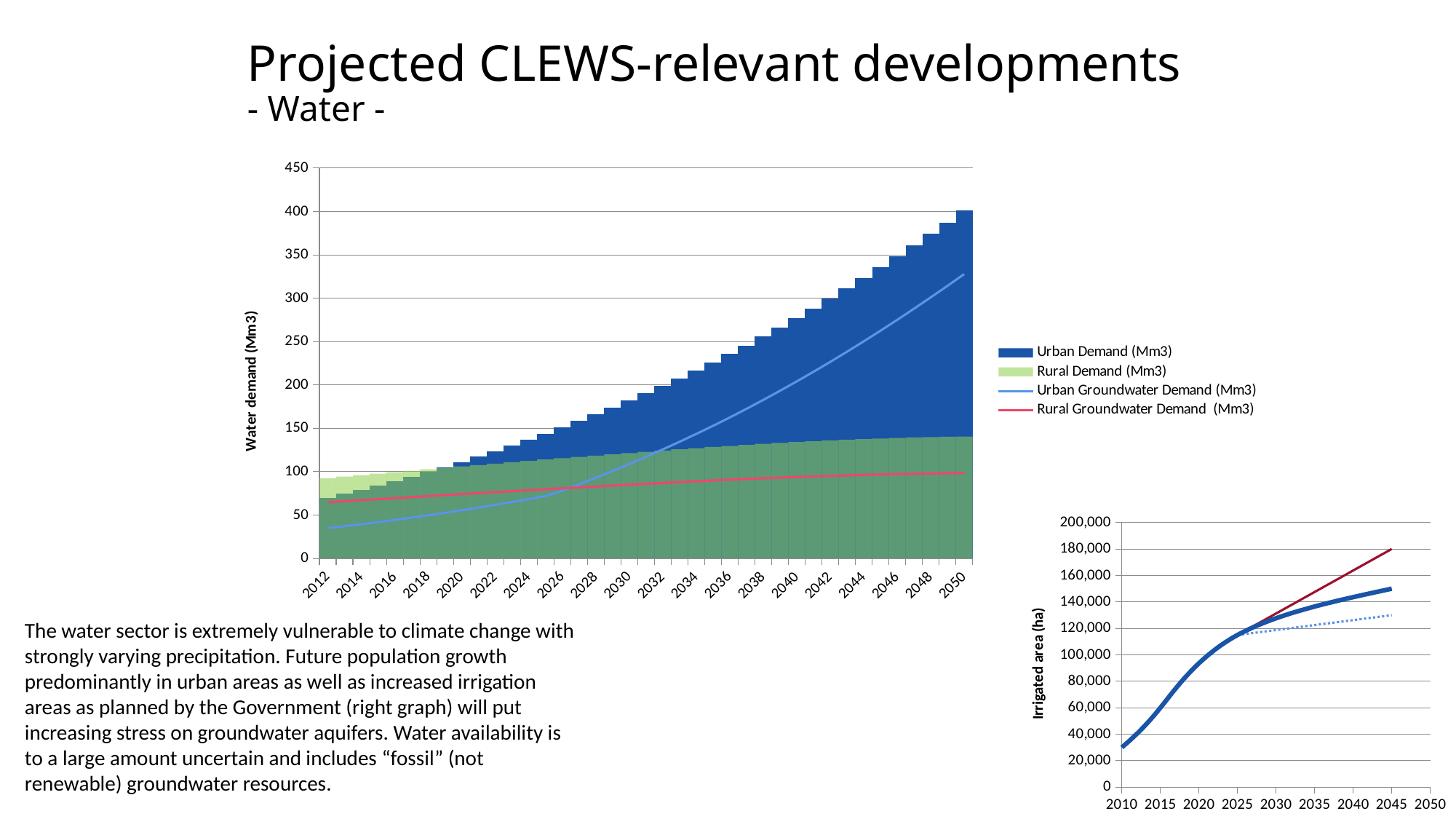
On the left chart, is the Urban Groundwater Demand (Mm3) value for 2050 greater or less than 300? greater What kind of chart is the chart on the right of the slide? line chart On the left chart, does Urban Groundwater Demand (Mm3) rise or fall from 2012 to 2050? rise On the left chart, is the total stacked value for 2050 greater or less than 350? greater On the right chart, is the irrigated area value for 2010 greater or less than 40,000? less On the left chart, in 2050, which is larger: Urban Groundwater Demand (Mm3) or Rural Groundwater Demand (Mm3)? Urban Groundwater Demand (Mm3) On the right chart, does the irrigated area rise or fall from 2010 to 2045? rise On the right chart, what is the y-axis title? Irrigated area (ha) On the left chart, how many series does the legend list? 4 On the left chart, what is the y-axis title? Water demand (Mm3)